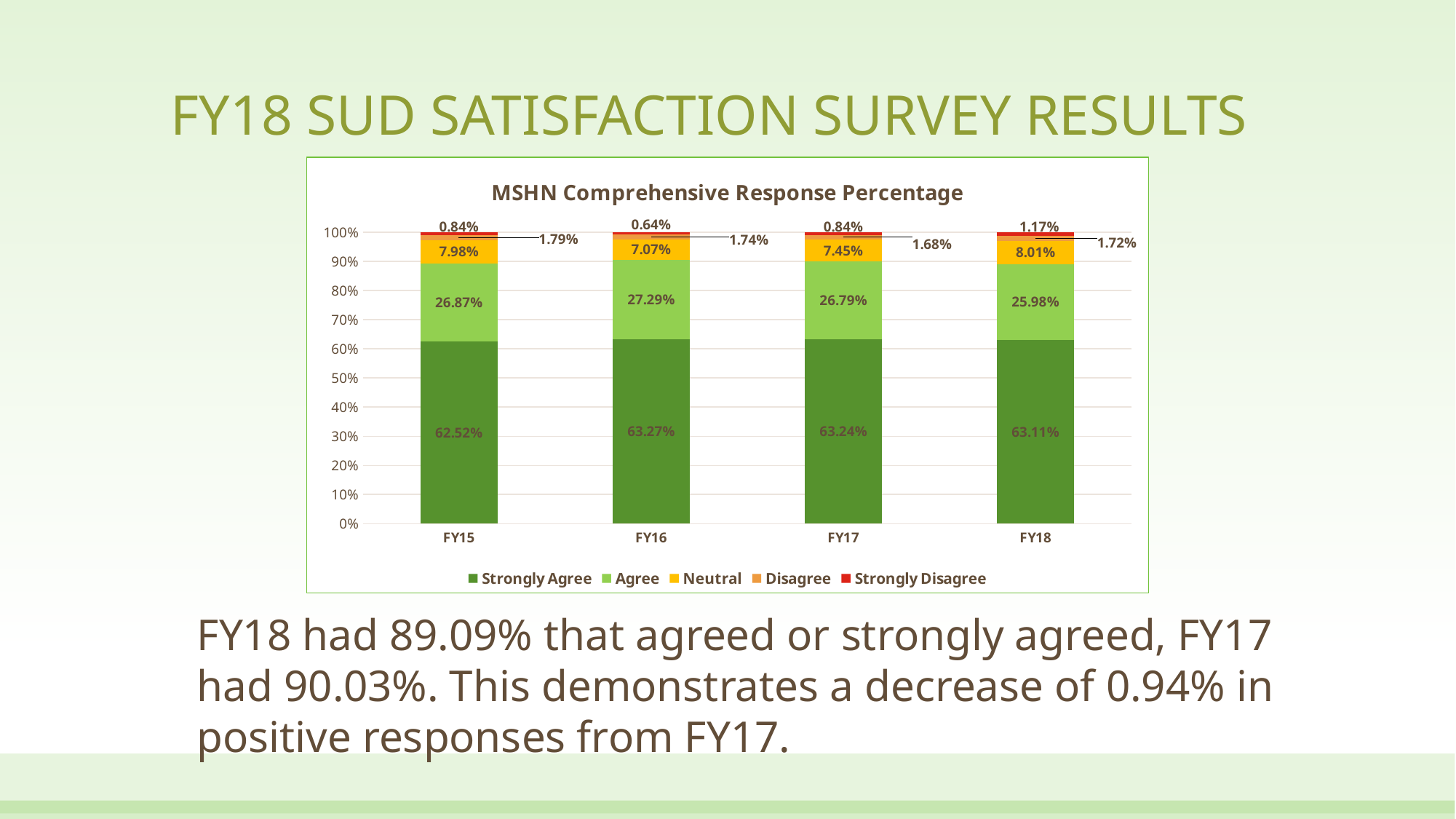
What kind of chart is shown on the slide? Stacked bar chart Which has a larger Agree percentage, FY15 or FY17? FY15 How many series does the chart legend list? 5 What is the Agree percentage for FY18? 25.98% Which fiscal year has the lowest Agree percentage? FY18 What is the Neutral percentage for FY16? 7.07% What is the Strongly Disagree percentage for FY18? 1.17% How many fiscal years are shown on the x axis of the chart? 4 What is the difference between the Neutral percentage for FY18 and for FY16? 0.94% What is the Strongly Agree percentage for FY15? 62.52% Which fiscal year has the highest Strongly Agree percentage? FY16 What is the title of the chart? MSHN Comprehensive Response Percentage